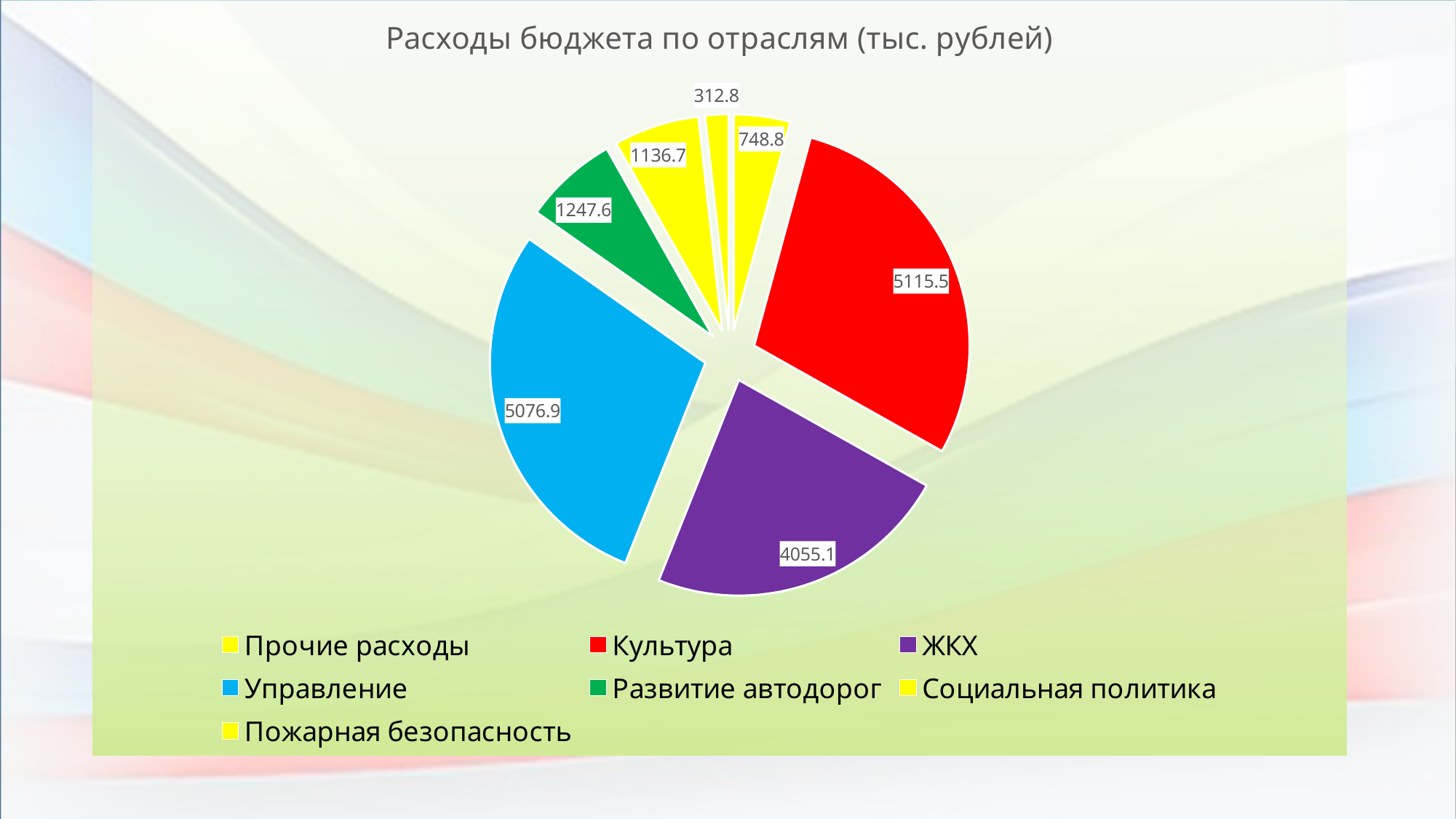
What is the smallest value shown on the pie chart? 312.8 What is the value for ЖКХ? 4055.1 What colour is the slice for Культура? Red What is the difference between the values for Культура and ЖКХ? 1060.4 Which category has the largest value? Культура What type of chart is shown on the slide? Pie chart What is the value for Культура? 5115.5 What is the title of the chart? Расходы бюджета по отраслям (тыс. рублей) What is the value for Развитие автодорог? 1247.6 How many slices does the pie chart have? 7 What is the value for Управление? 5076.9 Which is larger, the value for ЖКХ or the value for Управление? Управление